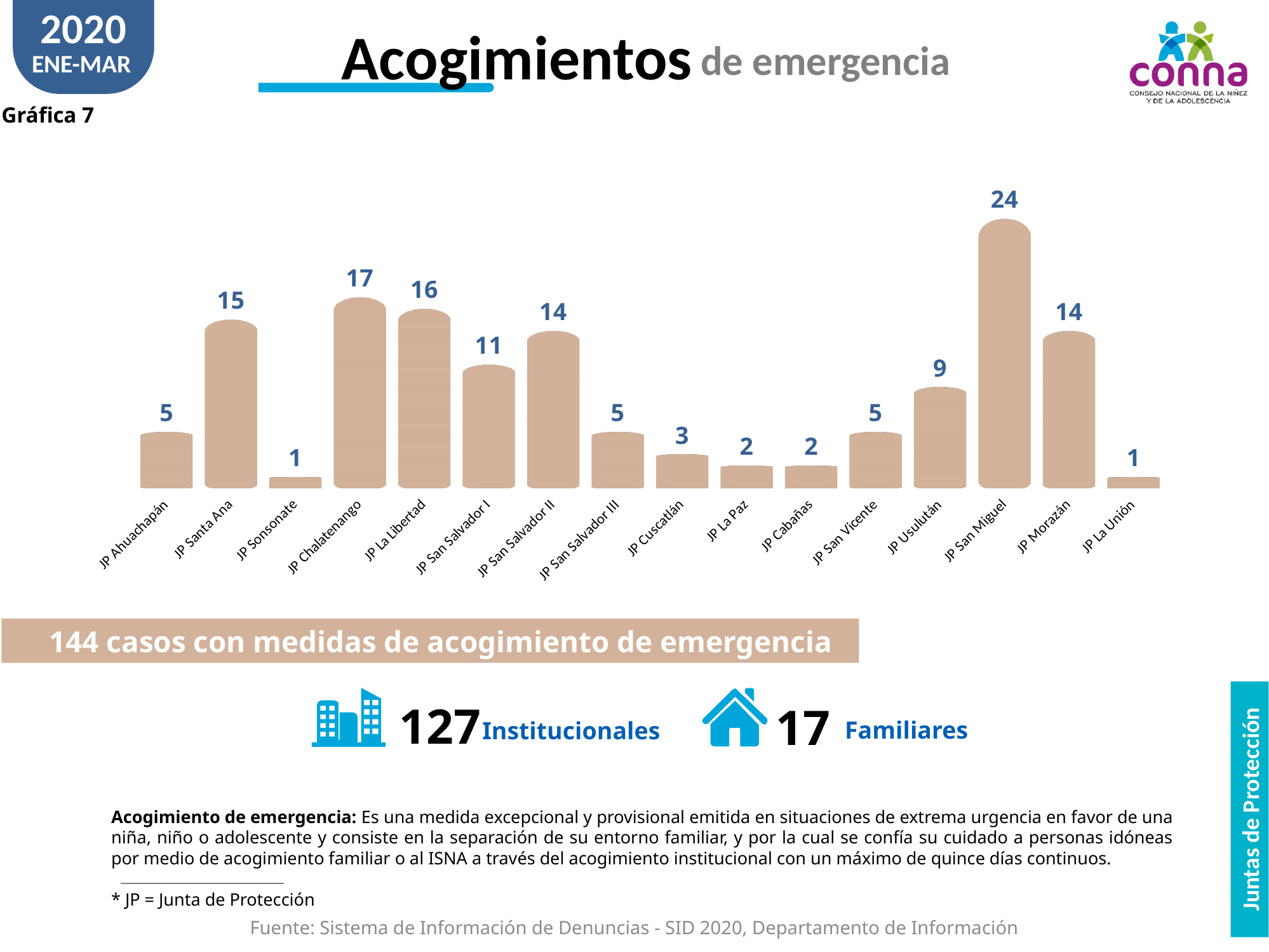
What kind of chart is shown on the slide? Bar chart Which is larger, the value for JP Santa Ana or the value for JP Morazán? JP Santa Ana What is the value for JP Usulután? 9 What is the total number of cases with emergency placement measures shown on the slide? 144 What is the difference between the values for JP San Miguel and JP Chalatenango? 7 Which is larger, the value for JP Usulután or the value for JP San Vicente? JP Usulután What is the value for JP Chalatenango? 17 What is the value for JP San Miguel? 24 Which Junta de Protección has the highest number of acogimientos de emergencia? JP San Miguel What is the value for JP Cuscatlán? 3 What is the difference between the values for JP La Libertad and JP San Salvador I? 5 How many Juntas de Protección are shown on the chart? 16